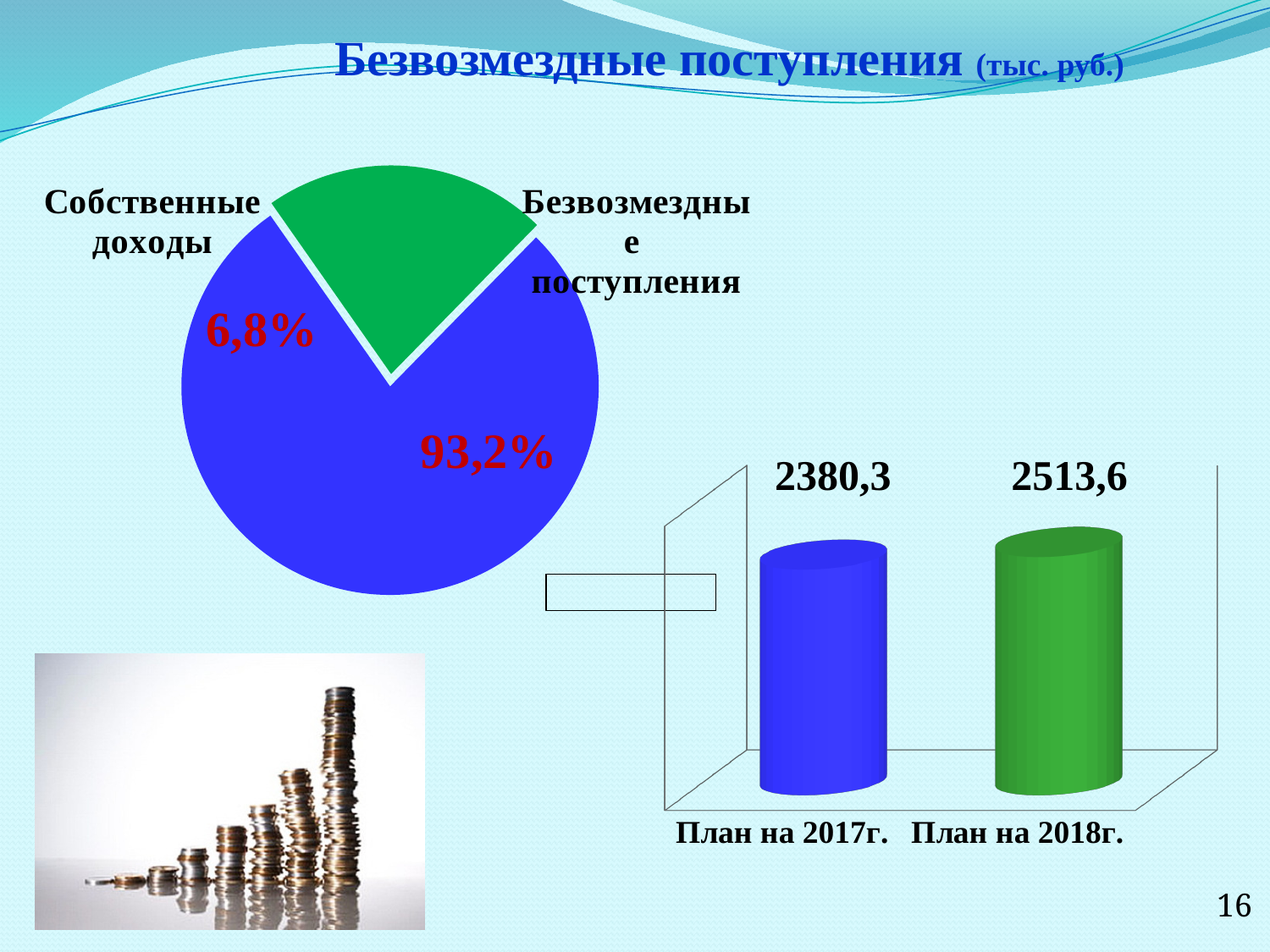
What kind of chart is shown at the bottom right of the slide? Bar chart On the pie chart, which slice is larger: Собственные доходы or Безвозмездные поступления? Собственные доходы On the bar chart at the bottom right, do the values rise or fall from План на 2017г. to План на 2018г.? Rise What kind of chart is shown on the left side of the slide? Pie chart On the pie chart, what share is shown for Собственные доходы? 93,2% On the bar chart at the bottom right, which category has the higher value? План на 2018г. On the bar chart at the bottom right, what is the value for План на 2018г.? 2513,6 On the bar chart at the bottom right, how many bars are plotted? 2 On the bar chart at the bottom right, what is the value for План на 2017г.? 2380,3 On the bar chart at the bottom right, which category has the lower value? План на 2017г. On the pie chart, what share is shown for Безвозмездные поступления? 6,8% On the bar chart at the bottom right, what is the difference between the values for План на 2018г. and План на 2017г.? 133,3